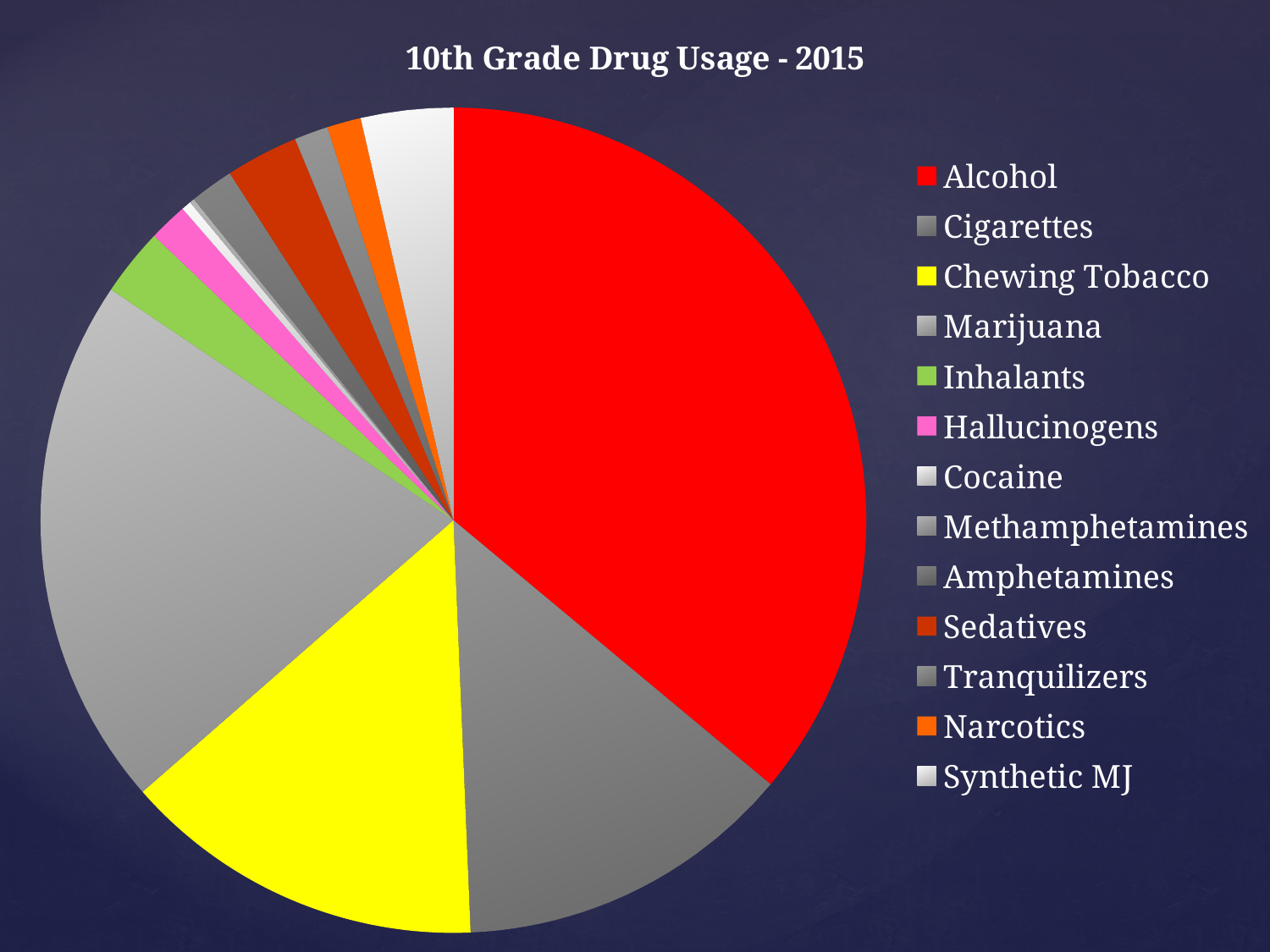
What colour is the Alcohol slice? Red Which is larger, the slice for Alcohol or the slice for Marijuana? Alcohol Which is larger, the slice for Marijuana or the slice for Chewing Tobacco? Marijuana What kind of chart is shown on the slide? Pie chart Which is larger, the slice for Marijuana or the slice for Cigarettes? Marijuana Which category has the largest slice of the pie? Alcohol Does the Alcohol slice account for more or less than half of the pie? less How many categories does the legend list? 13 What is the title of the chart? 10th Grade Drug Usage - 2015